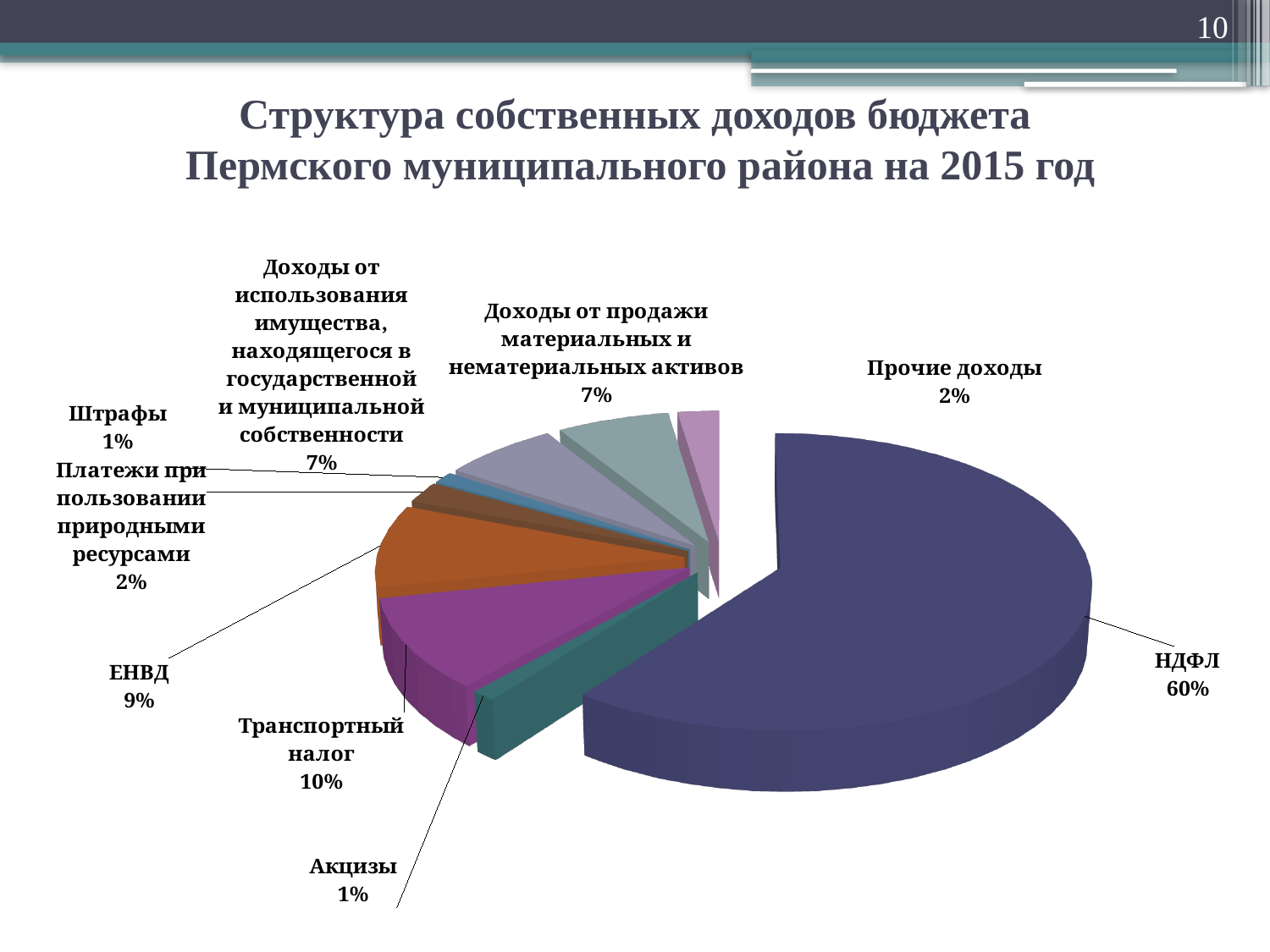
What is the title of the slide? Структура собственных доходов бюджета Пермского муниципального района на 2015 год What percentage is shown for Транспортный налог? 10% What percentage is shown for Прочие доходы? 2% What percentage is shown for Доходы от продажи материальных и нематериальных активов? 7% Which category has the largest share of the pie? НДФЛ What is the difference in percentage points between НДФЛ and Транспортный налог? 50 What share of the pie does НДФЛ account for? 60% What is the value for Акцизы? 1% What type of chart is shown on the slide? Pie chart Which is larger, the share for ЕНВД or the share for Транспортный налог? Транспортный налог How many categories are shown in the pie chart? 9 What is the value for ЕНВД? 9%